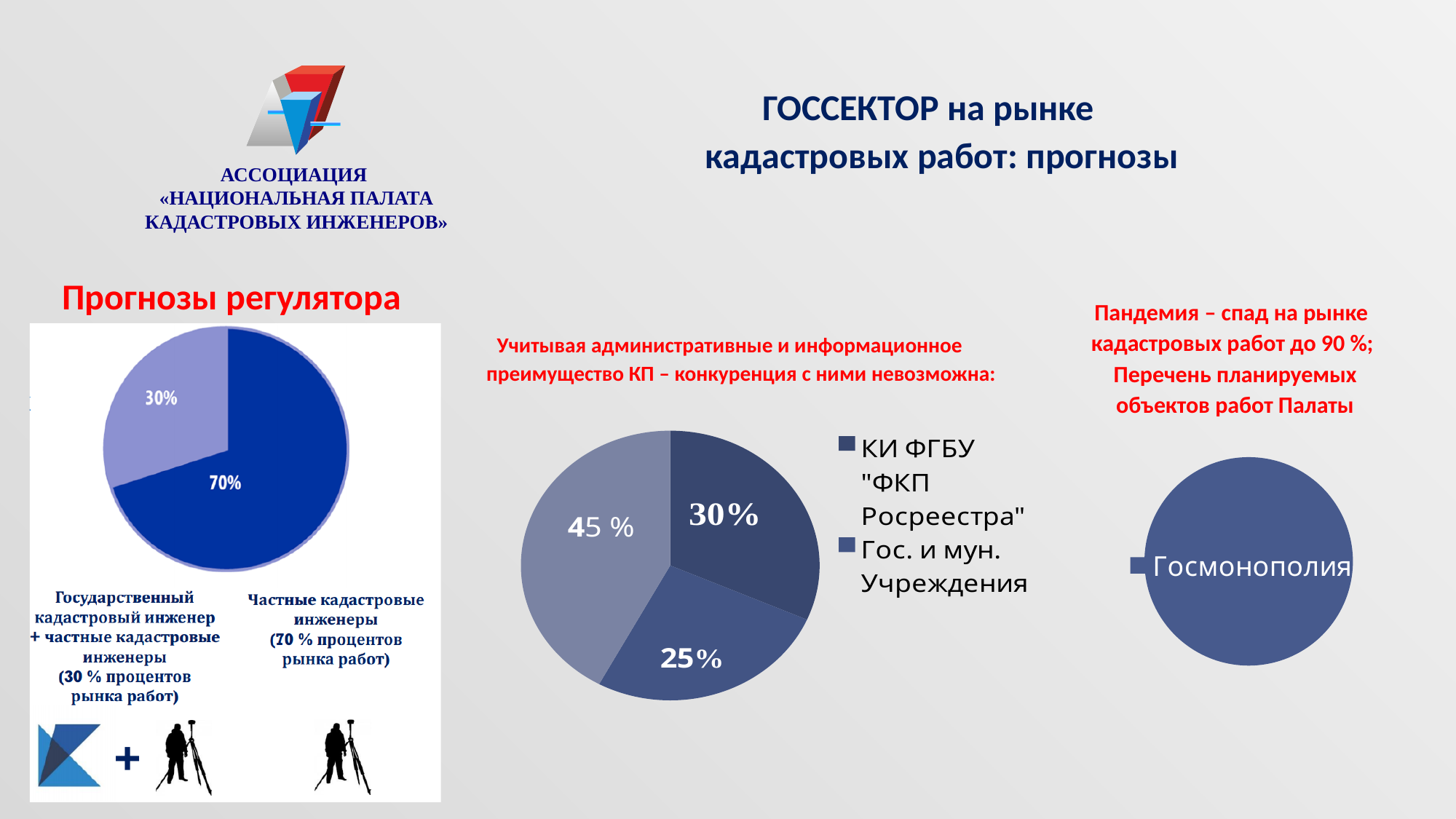
In the middle pie chart, what value is shown for "КИ ФГБУ "ФКП Росреестра""? 30% What is the only legend entry of the pie chart on the right? Госмонополия How many entries does the legend of the middle pie chart list? 2 In the middle pie chart, what is the smallest slice value? 25% In the left chart under "Прогнозы регулятора", what share of the market is labelled for "Частные кадастровые инженеры"? 70% How many slices does the middle pie chart have? 3 In the left chart under "Прогнозы регулятора", which category has the larger slice? Частные кадастровые инженеры What kind of chart is shown on the left under "Прогнозы регулятора"? Pie chart In the middle pie chart, what is the largest slice value? 45 % In the left chart under "Прогнозы регулятора", what share is shown for "Государственный кадастровый инженер + частные кадастровые инженеры"? 30% In the middle pie chart, what value is shown for "Гос. и мун. Учреждения"? 25% In the left chart under "Прогнозы регулятора", what is the difference between the two slices? 40%